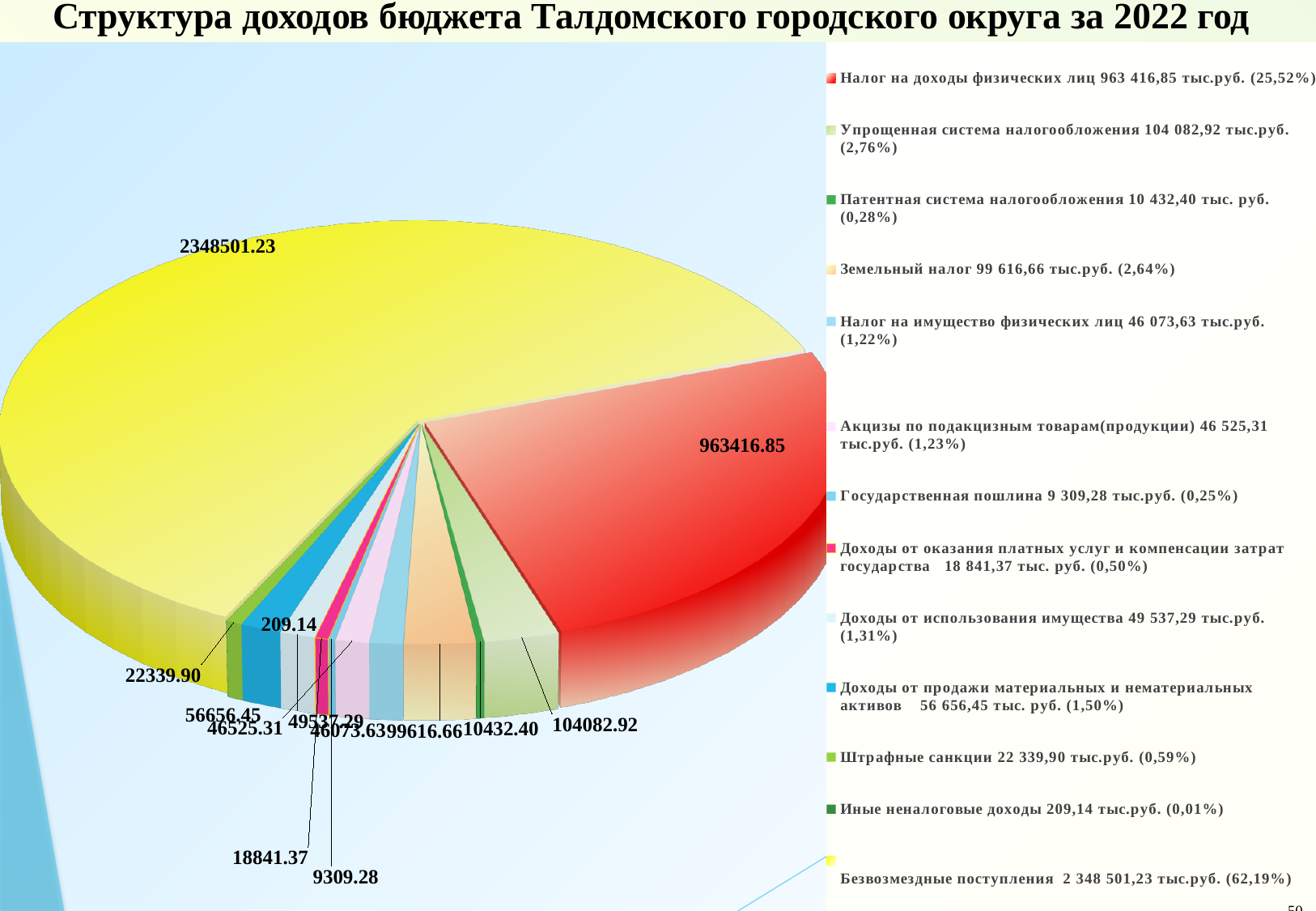
What is the data label value for Штрафные санкции? 22339.90 Which is larger: the value for Упрощенная система налогообложения or the value for Земельный налог? Упрощенная система налогообложения What is the difference between the data label values for Безвозмездные поступления and Налог на доходы физических лиц? 1385084.38 What kind of chart is shown on the slide? pie chart Which category has the largest slice of the pie? Безвозмездные поступления How many categories (slices) does the pie chart have? 13 What is the data label value for Государственная пошлина? 9309.28 What share of the pie does Безвозмездные поступления represent, according to the legend? 62,19% Which category has the smallest slice of the pie? Иные неналоговые доходы What share of the pie does Упрощенная система налогообложения represent, according to the legend? 2,76% What is the data label value for Налог на доходы физических лиц? 963416.85 What is the title of the chart slide? Структура доходов бюджета Талдомского городского округа за 2022 год